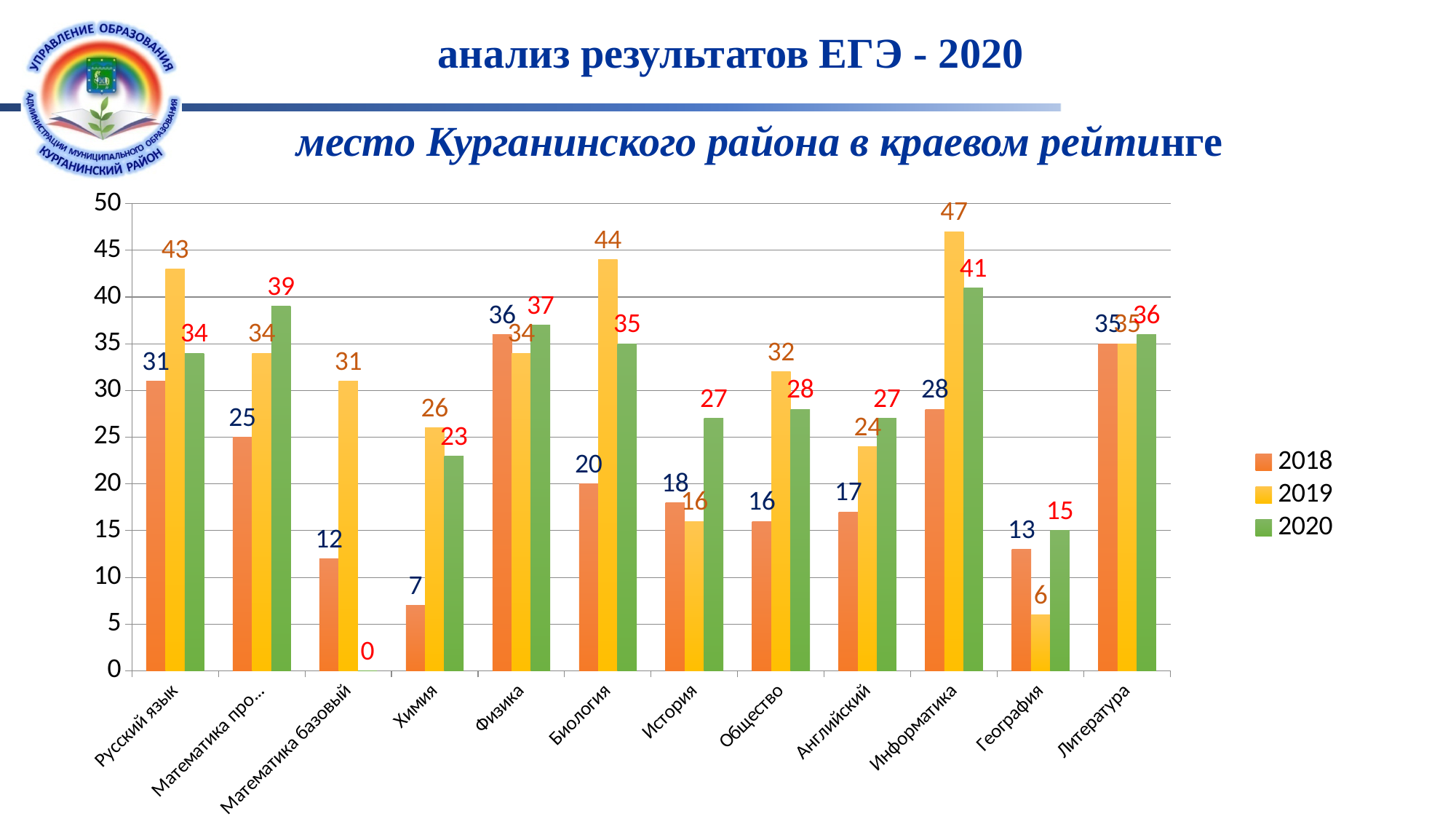
Which is larger for История: the 2018 value or the 2020 value? 2020 What is the difference between the 2019 and 2018 values for Биология? 24 What is the value for Математика базовый in the 2020 series? 0 What is the value for Информатика in the 2019 series? 47 Which category has the lowest value in the 2019 series? География Which category has the highest value in the 2019 series? Информатика What kind of chart is shown on the slide? Bar chart How many series does the legend list? 3 Which category has the lowest value in the 2018 series? Химия Which colour represents the 2020 series in the legend? Green How many categories are shown on the x axis? 12 What is the value for Химия in the 2018 series? 7